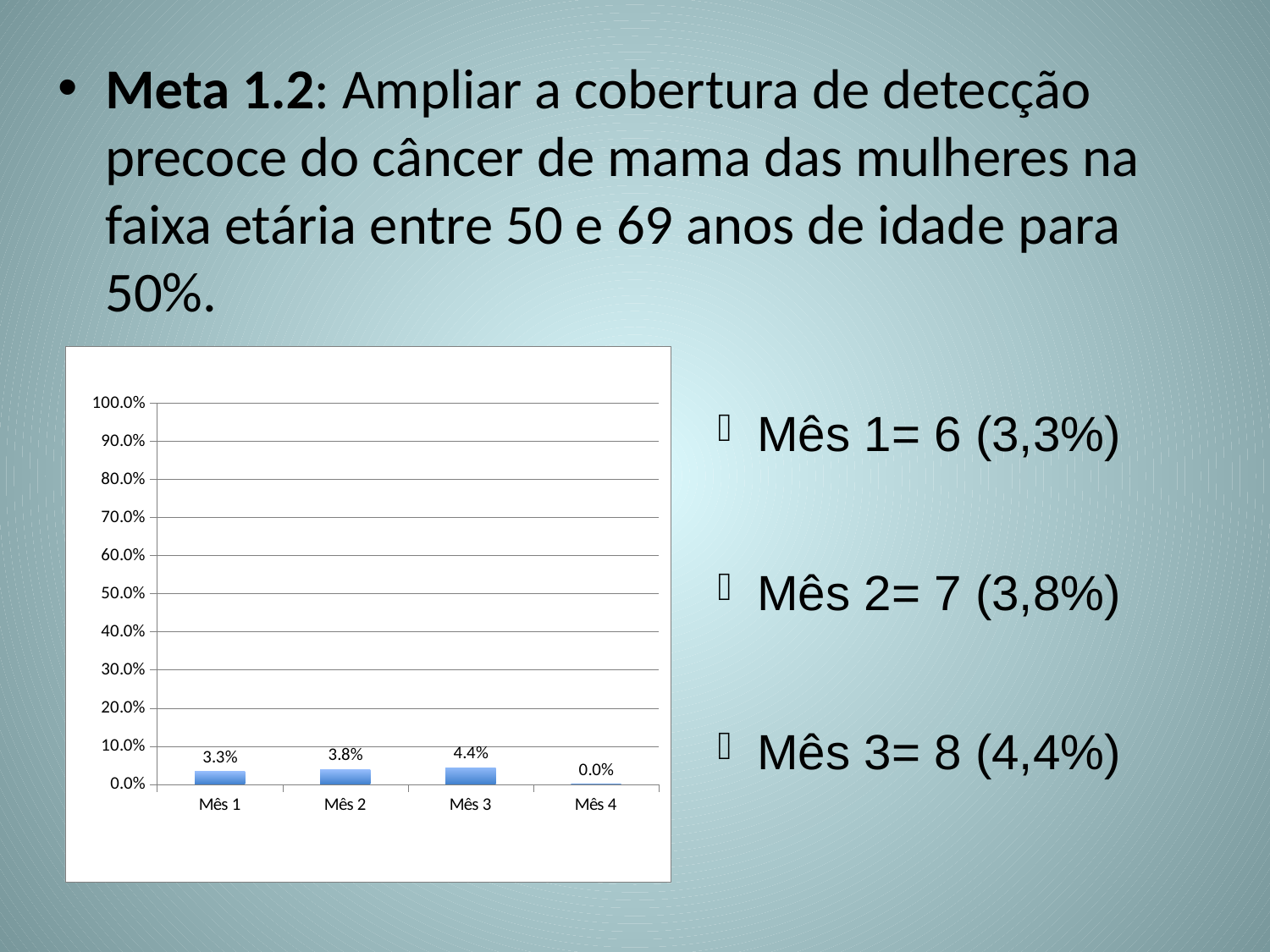
What is the value for Mês 4? 0.0% What is the value for Mês 2? 3.8% What is the difference between the values for Mês 3 and Mês 1? 1.1% Which is larger, the value for Mês 2 or the value for Mês 1? Mês 2 Which month has the highest value? Mês 3 What kind of chart is shown on the slide? bar chart How many months are shown on the x axis of the chart? 4 Is the value for Mês 3 greater or less than 10.0%? less What is the value for Mês 3? 4.4% Which month has the lowest value? Mês 4 Do the values rise or fall from Mês 1 to Mês 3? rise What is the value for Mês 1? 3.3%